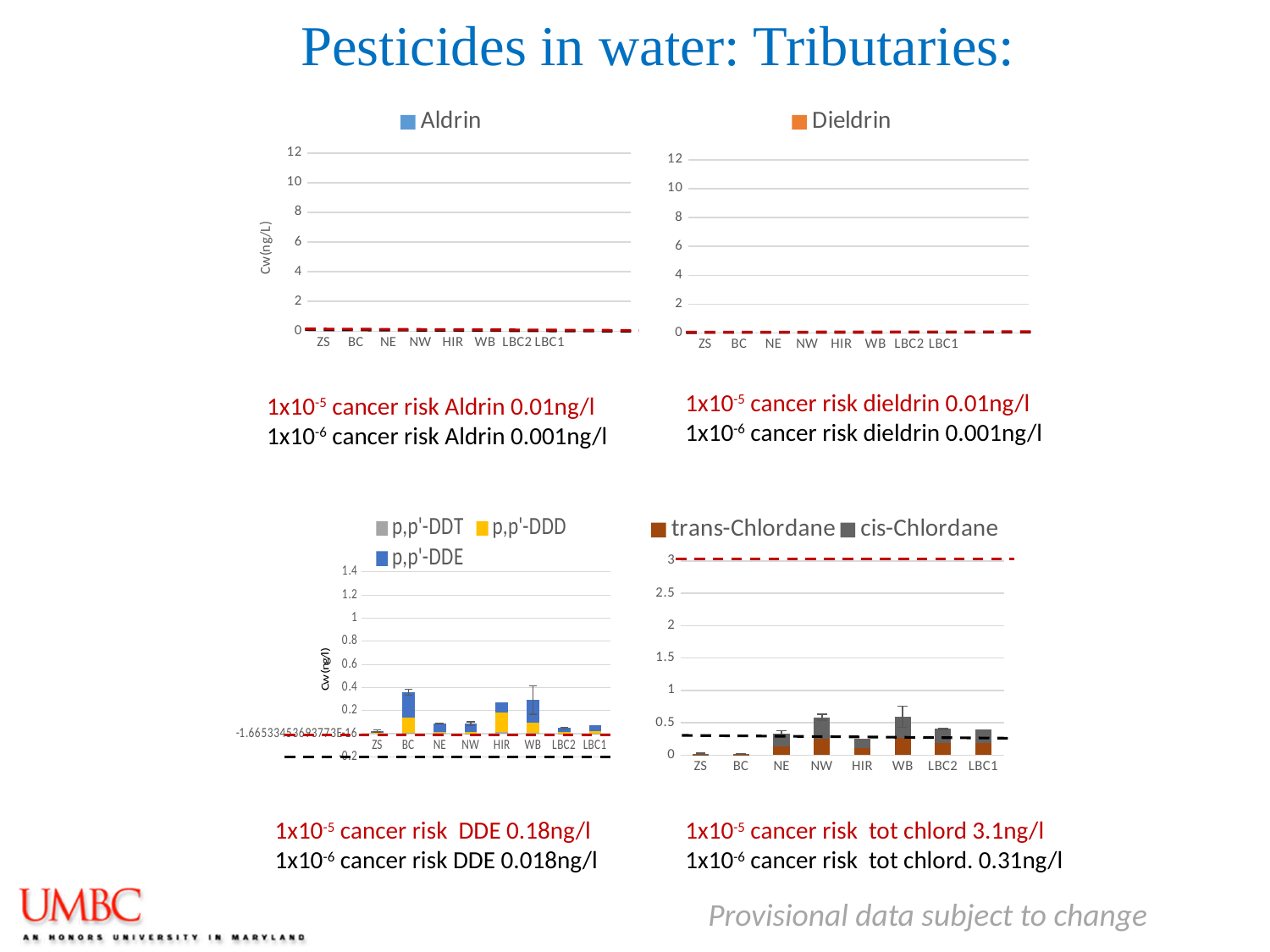
In the bottom-right chlordane chart, is the stacked value for NE greater or less than 0.5? less In the bottom-right chlordane chart, is the stacked value for NW greater or less than 1? less In the Aldrin chart, is the value for ZS greater or less than 2? less How many categories are shown on the x axis of the Dieldrin chart? 8 What is the y-axis label on the Aldrin chart? Cw(ng/L) In the bottom-right chlordane chart, which has the larger stacked value, NW or HIR? NW In the bottom-left DDT/DDD/DDE chart, which has the larger stacked value, BC or NE? BC What are the two legend entries of the bottom-right chart? trans-Chlordane and cis-Chlordane How many series does the legend of the bottom-right chlordane chart list? 2 How many series does the legend of the bottom-left chart (p,p'-DDT, p,p'-DDD, p,p'-DDE) list? 3 What kind of chart is the Aldrin chart at the top left of the slide? bar chart